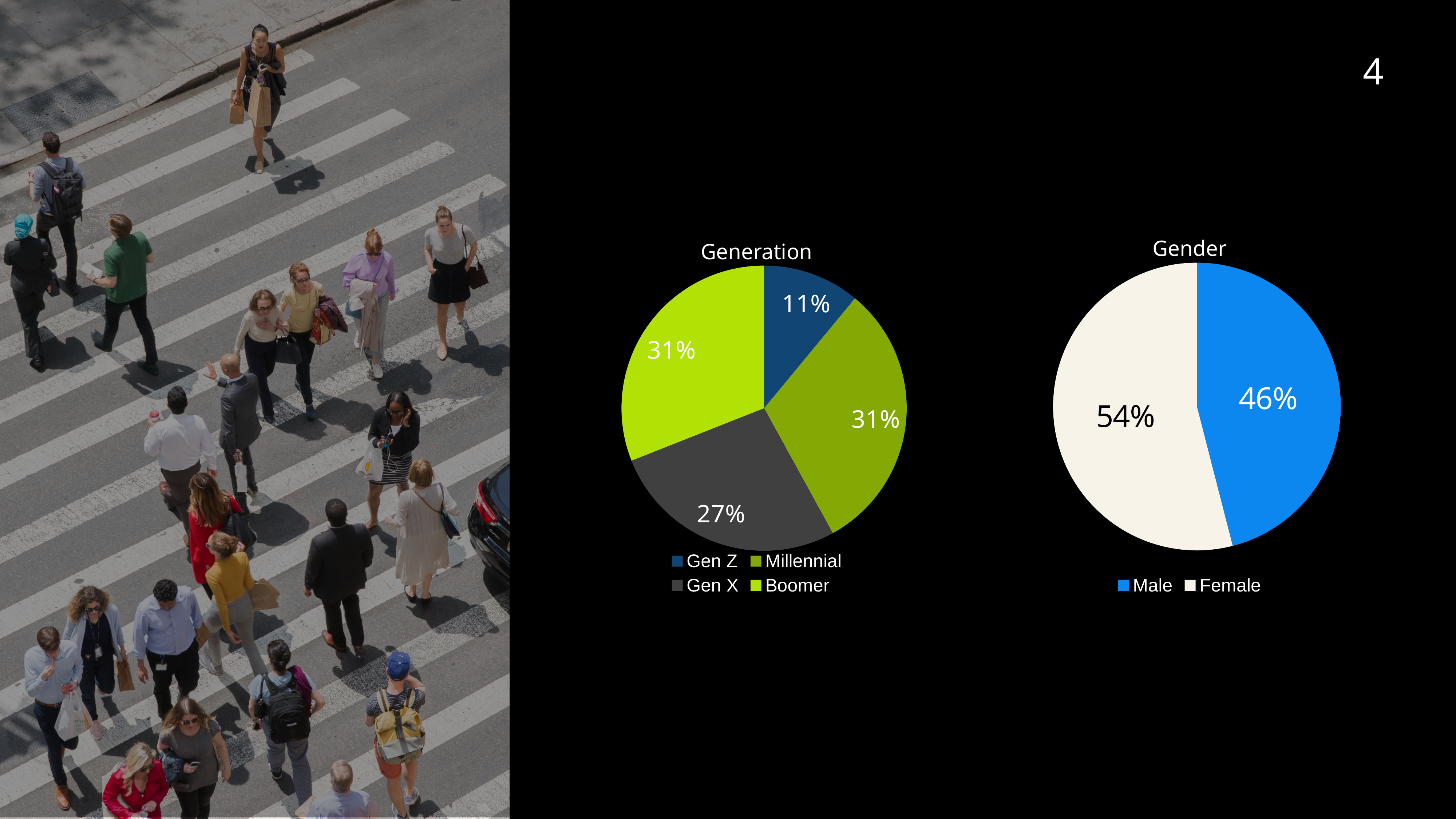
In the Generation chart, which generation has the smallest share? Gen Z In the Generation chart, what share is Gen Z? 11% In the Gender chart, what share is Male? 46% In the Generation chart, what is the difference between the Boomer share and the Gen X share? 4% How many categories does the Generation chart show? 4 What type of chart is the Gender chart? Pie chart In the Gender chart, what is the difference between the Female and Male shares? 8% In the Generation chart, which is larger, Gen X or Gen Z? Gen X In the Generation chart, what share is Millennial? 31% In the Generation chart, what share is Gen X? 27% In the Gender chart, what share is Female? 54% In the Gender chart, which gender has the larger share? Female